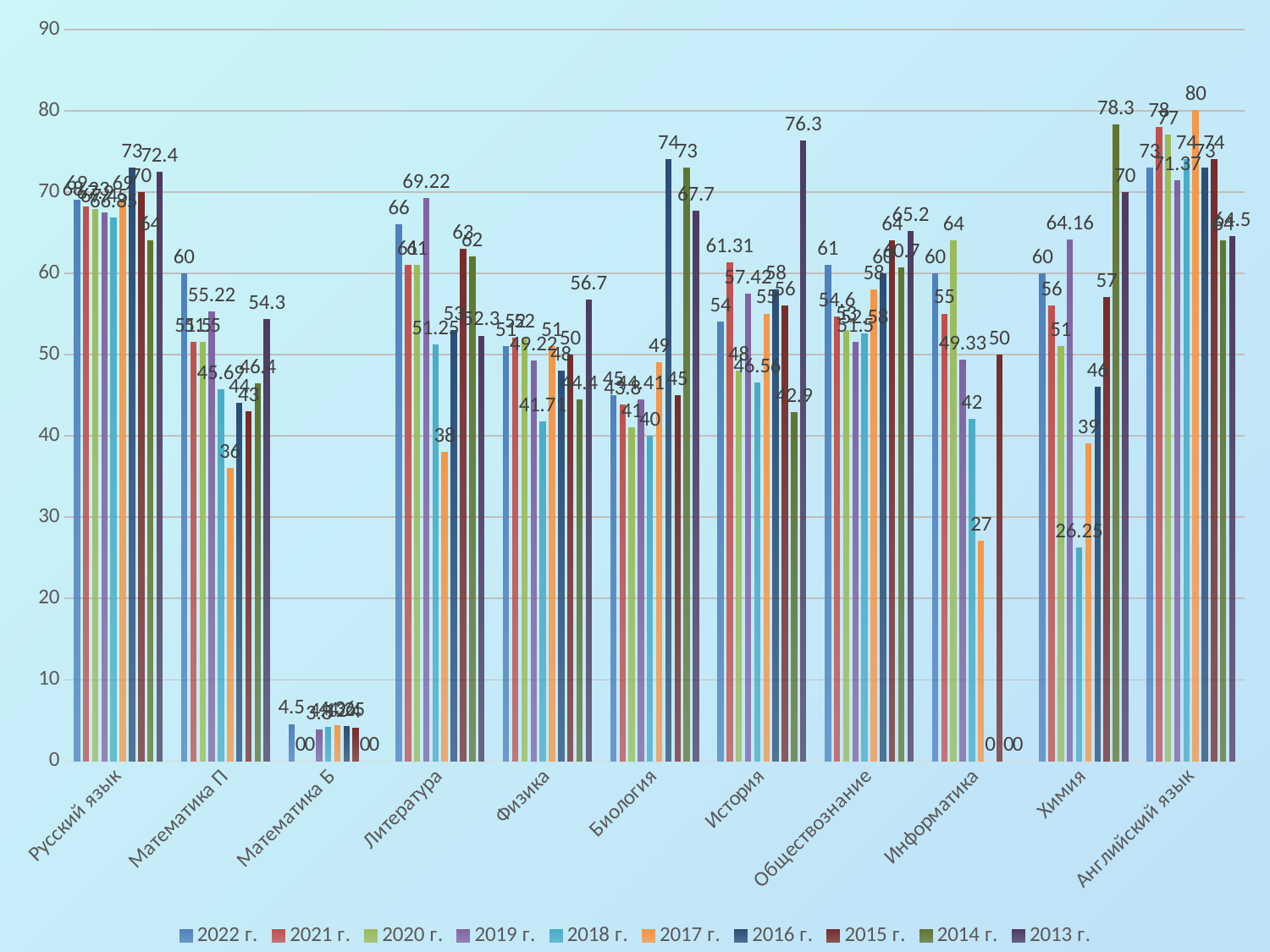
How many series does the legend list? 10 Which series has the highest value for Английский язык? 2017 г. What is the value for Литература in the 2019 г. series? 69.22 What is the value for Информатика in the 2017 г. series? 27 How many subject categories are shown on the x axis? 11 What is the value for История in the 2013 г. series? 76.3 Is the value for Математика П in the 2022 г. series greater or less than 50? greater Which series has the lowest value for Химия? 2018 г. For Биология, which is larger: the 2016 г. value or the 2013 г. value? 2016 г. What is the value for Химия in the 2018 г. series? 26.25 For Информатика, what is the difference between the 2020 г. value and the 2017 г. value? 37 What kind of chart is shown on the slide? bar chart